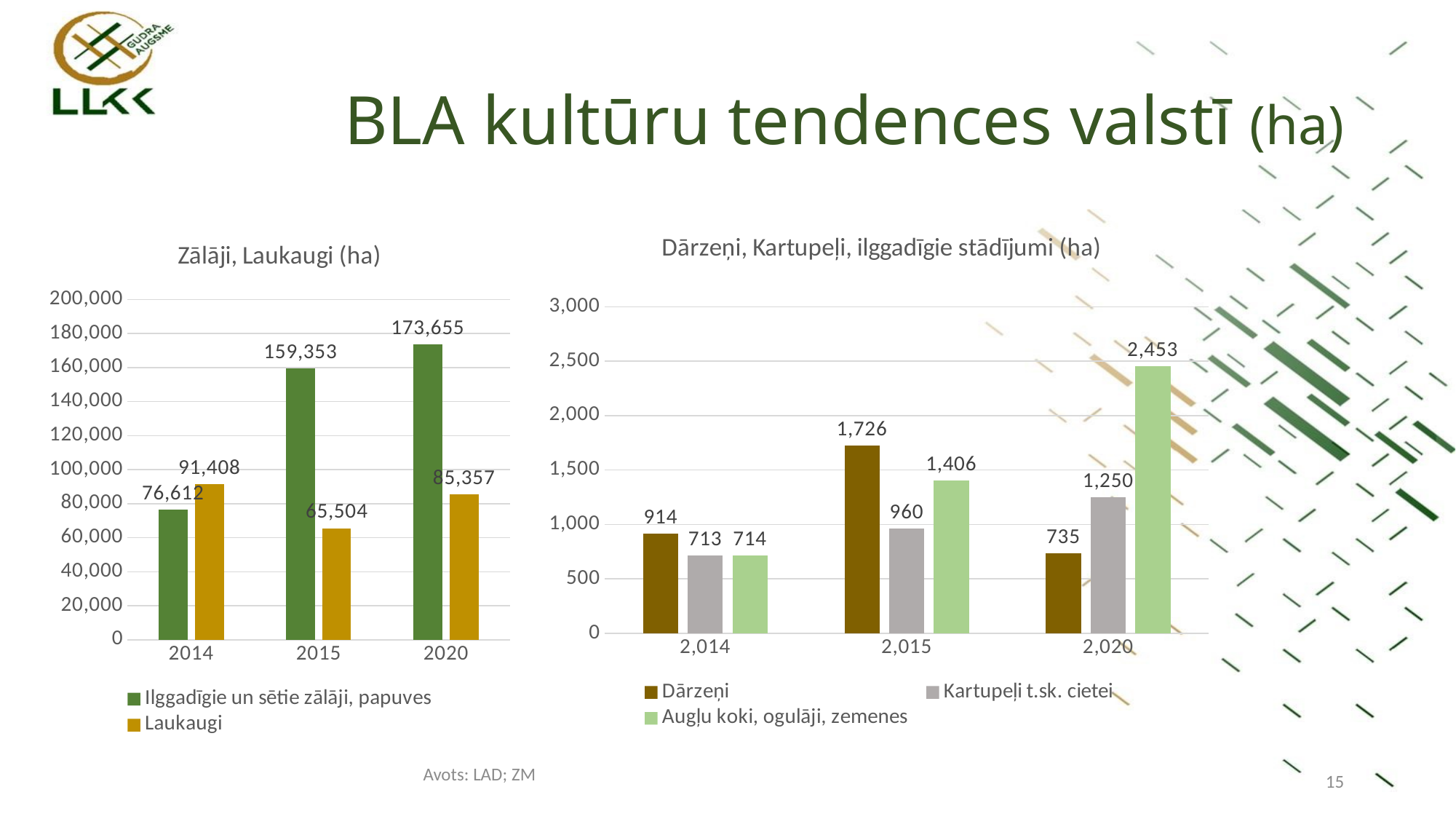
In the chart titled "Dārzeņi, Kartupeļi, ilggadīgie stādījumi (ha)", what is the difference between the Kartupeļi t.sk. cietei values in 2020 and 2014? 537 In the chart titled "Zālāji, Laukaugi (ha)", in which year is the Laukaugi value highest? 2014 In the chart titled "Zālāji, Laukaugi (ha)", how many series does the legend list? 2 In the chart titled "Dārzeņi, Kartupeļi, ilggadīgie stādījumi (ha)", what is the value for Augļu koki, ogulāji, zemenes in 2020? 2,453 In the chart titled "Zālāji, Laukaugi (ha)", does the Ilggadīgie un sētie zālāji, papuves value rise or fall from 2014 to 2020? rise What kind of chart is the chart titled "Dārzeņi, Kartupeļi, ilggadīgie stādījumi (ha)"? bar chart In the chart titled "Zālāji, Laukaugi (ha)", what is the value for Ilggadīgie un sētie zālāji, papuves in 2020? 173,655 In the chart titled "Zālāji, Laukaugi (ha)", what is the value for Laukaugi in 2015? 65,504 In the chart titled "Dārzeņi, Kartupeļi, ilggadīgie stādījumi (ha)", in which year is the Dārzeņi value lowest? 2020 In the chart titled "Zālāji, Laukaugi (ha)", what is the difference between the Ilggadīgie un sētie zālāji, papuves value and the Laukaugi value in 2014? 14,796 In the chart titled "Dārzeņi, Kartupeļi, ilggadīgie stādījumi (ha)", what is the value for Dārzeņi in 2015? 1,726 In the chart titled "Dārzeņi, Kartupeļi, ilggadīgie stādījumi (ha)", which is larger in 2020: Kartupeļi t.sk. cietei or Dārzeņi? Kartupeļi t.sk. cietei